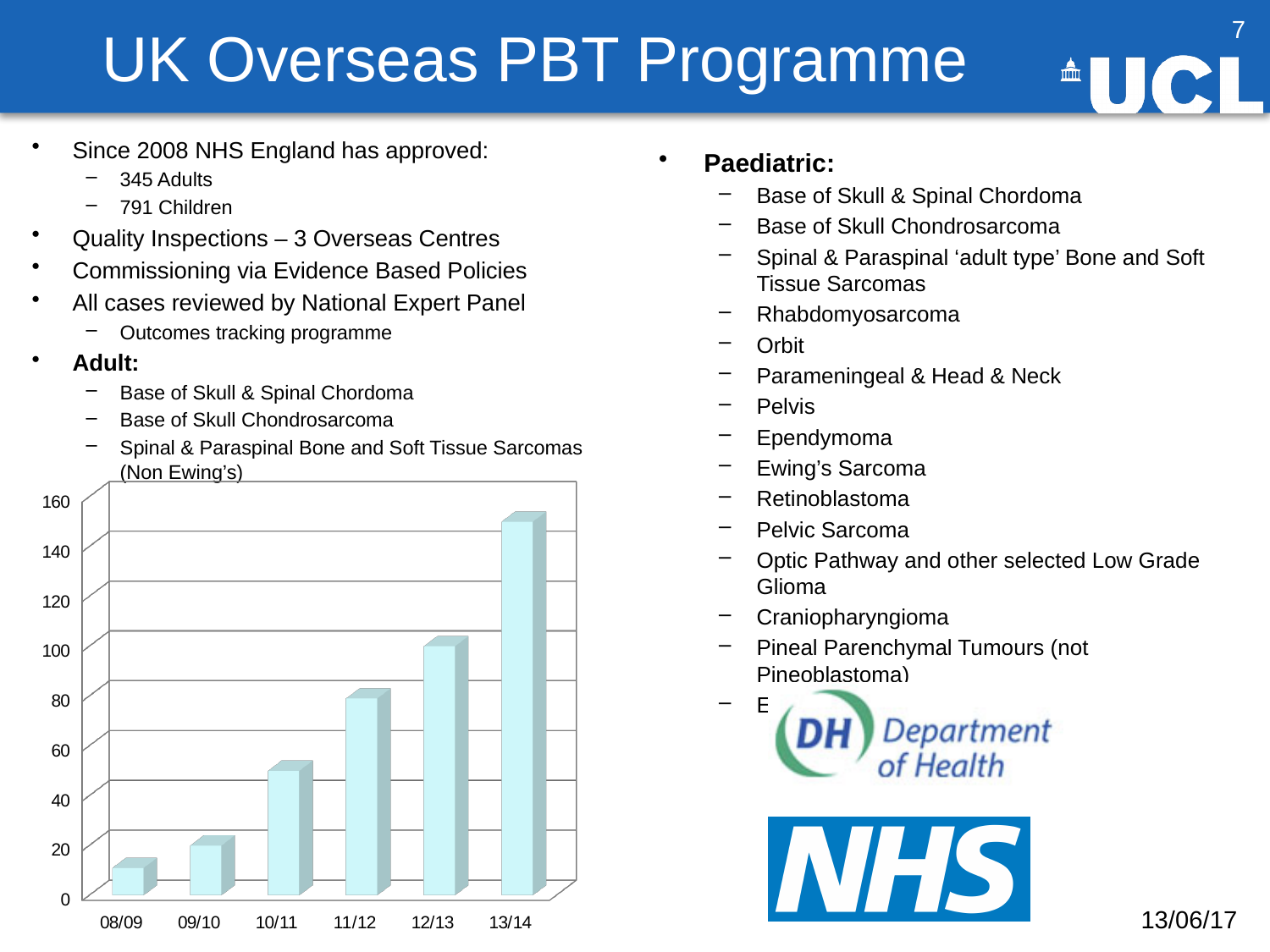
What kind of chart is shown on the slide? bar chart Is the value for 11/12 greater or less than 60? greater Do the values in the chart rise or fall from 08/09 to 13/14? rise How many categories are shown on the x axis of the chart? 6 Which category has the lowest bar in the chart? 08/09 Is the value for 08/09 greater or less than 20? less Which is larger in the chart, the value for 11/12 or the value for 10/11? 11/12 Is the value for 10/11 greater or less than 60? less Which is larger in the chart, the value for 12/13 or the value for 13/14? 13/14 Which category has the highest bar in the chart? 13/14 What is the highest value labelled on the vertical axis of the chart? 160